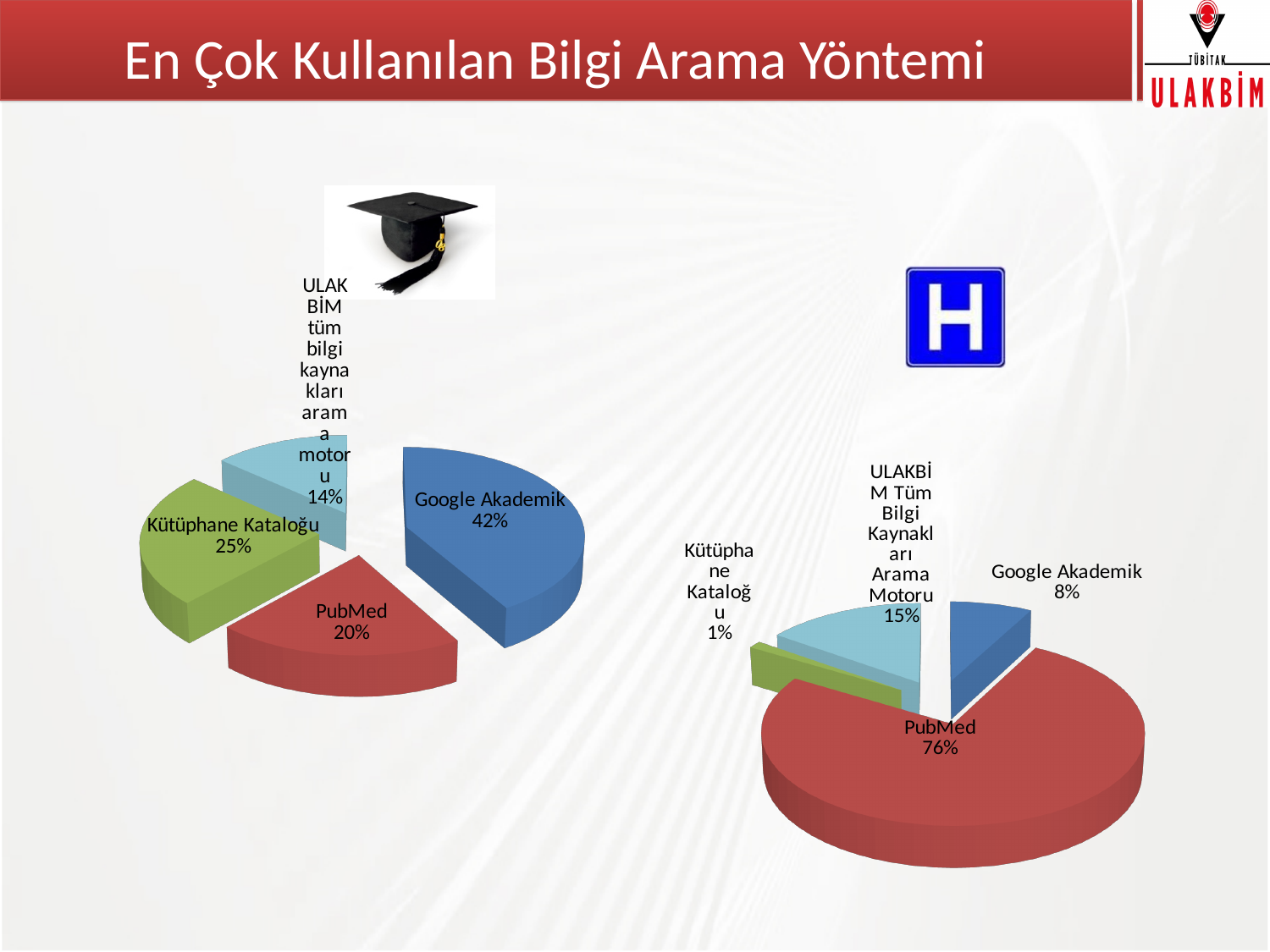
In the left pie chart, which category has the smallest share? ULAKBİM tüm bilgi kaynakları arama motoru In the left pie chart, what share does Google Akademik have? 42% In the right pie chart, what share does PubMed have? 76% In the right pie chart, which category has the smallest share? Kütüphane Kataloğu In the left pie chart, what share does Kütüphane Kataloğu have? 25% In the right pie chart, what is the difference between the PubMed share and the ULAKBİM Tüm Bilgi Kaynakları Arama Motoru share? 61% In the left pie chart, what share does PubMed have? 20% In the left pie chart, how many slices are there? 4 In the left pie chart, which category has the largest share? Google Akademik Which is larger in the left pie chart: the share for Kütüphane Kataloğu or the share for PubMed? Kütüphane Kataloğu In the right pie chart, what share does Google Akademik have? 8% What kind of chart is the chart on the left of the slide? Pie chart